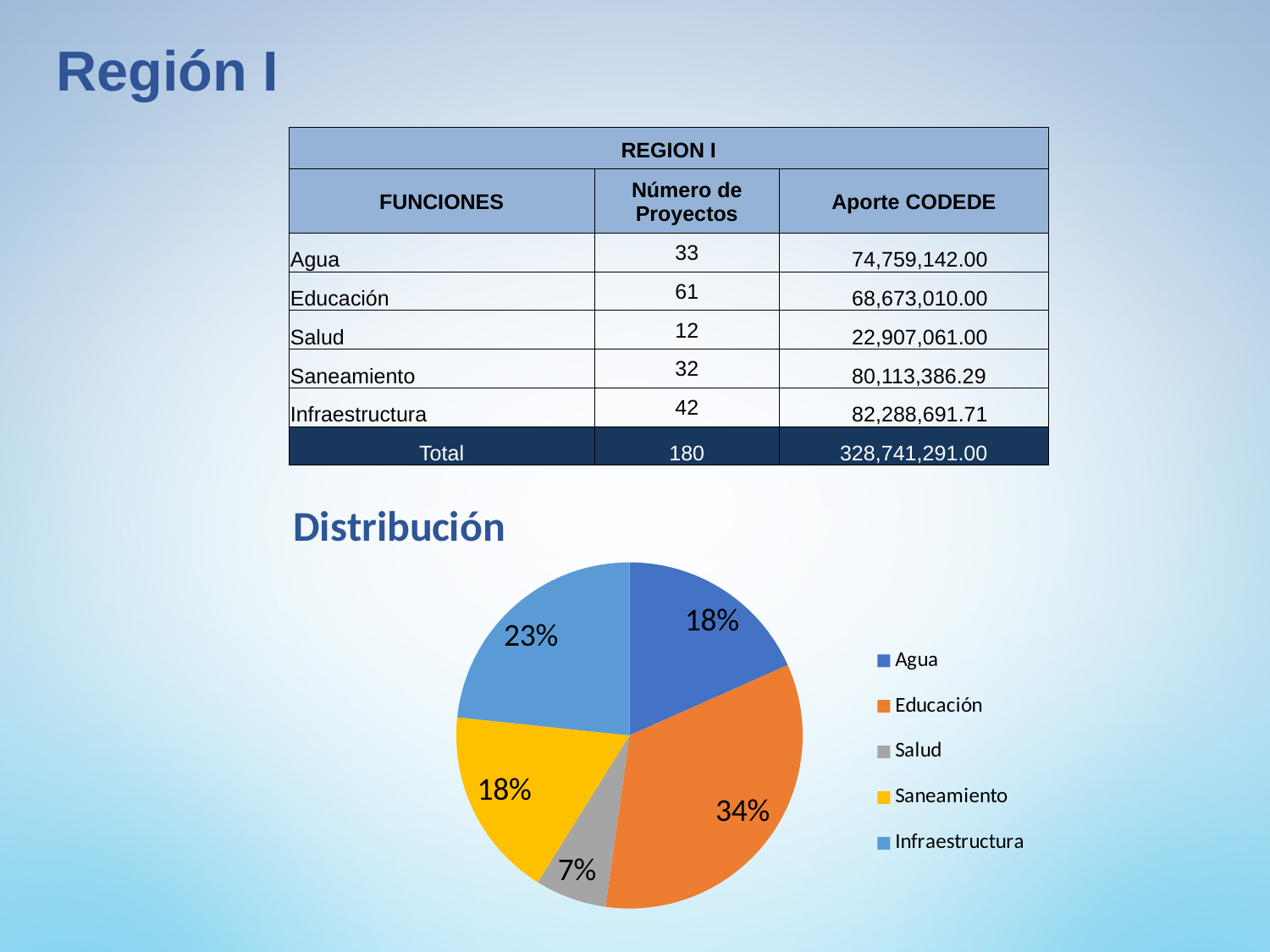
In the "Distribución" pie chart, what percentage is shown for Agua? 18% Which category has the largest slice in the "Distribución" pie chart? Educación How many slices does the "Distribución" pie chart have? 5 What kind of chart is shown under the title "Distribución"? pie chart In the "Distribución" pie chart, which slice is larger, Infraestructura or Salud? Infraestructura In the "Distribución" pie chart, what percentage is shown for Salud? 7% In the "Distribución" pie chart, what percentage is shown for Infraestructura? 23% In the "Distribución" pie chart, what colour is the Saneamiento slice? yellow In the "Distribución" pie chart, what percentage is shown for Educación? 34% In the "Distribución" pie chart, what is the difference in percentage points between Educación and Infraestructura? 11 How many entries does the legend of the "Distribución" pie chart list? 5 Which category has the smallest slice in the "Distribución" pie chart? Salud